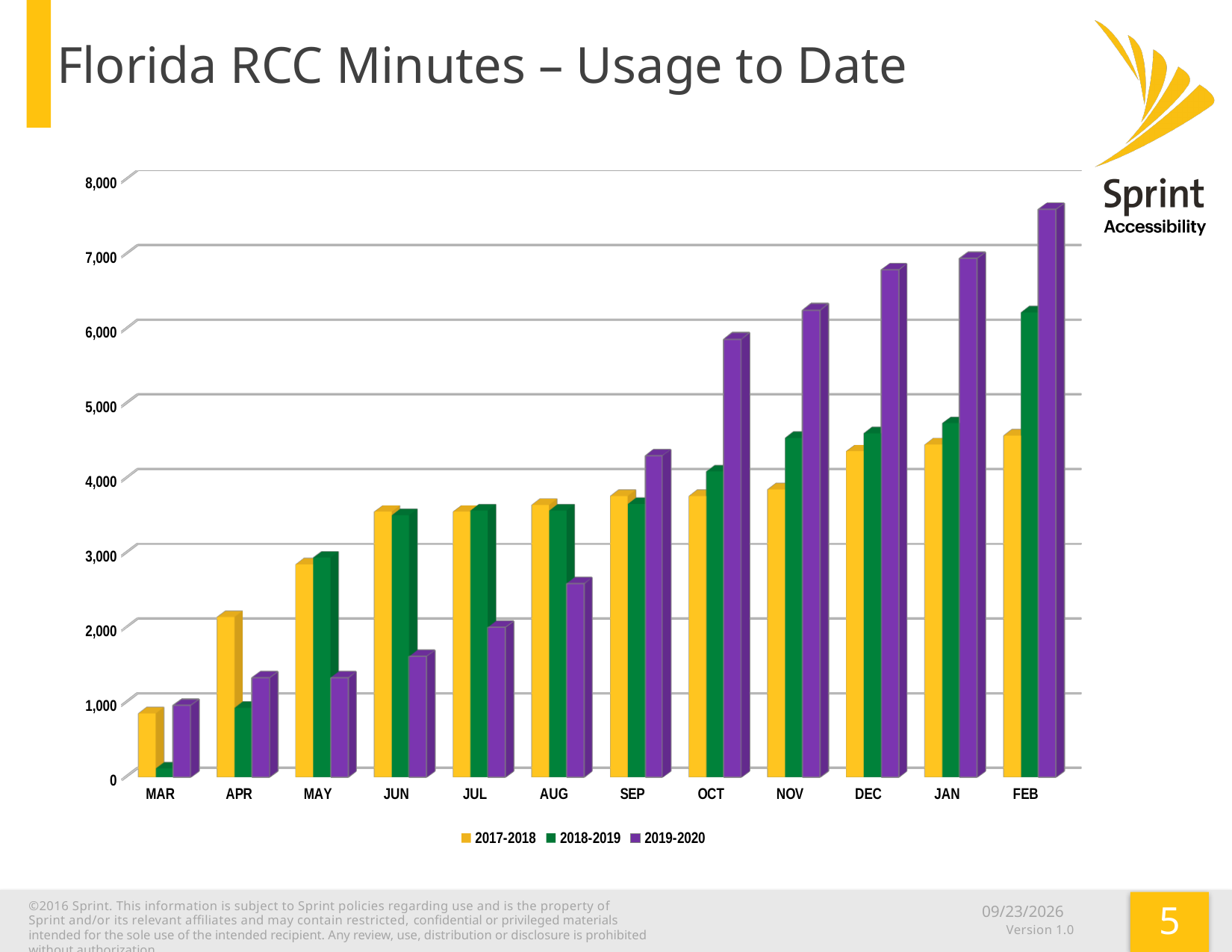
Do the 2019-2020 values generally rise or fall from MAR to FEB? rise What colour represents the 2019-2020 series in the legend? purple In which month is the 2019-2020 value highest? FEB Is the 2018-2019 value for FEB greater or less than 5,000? greater In OCT, which series has the larger value: 2017-2018 or 2019-2020? 2019-2020 Is the 2017-2018 value for APR greater or less than 3,000? less In which month is the 2018-2019 value lowest? MAR How many series does the legend list? 3 How many months are shown along the x axis? 12 In MAY, which series has the larger value: 2017-2018 or 2019-2020? 2017-2018 Is the 2019-2020 value for FEB greater or less than 7,000? greater What kind of chart is shown on the slide? bar chart